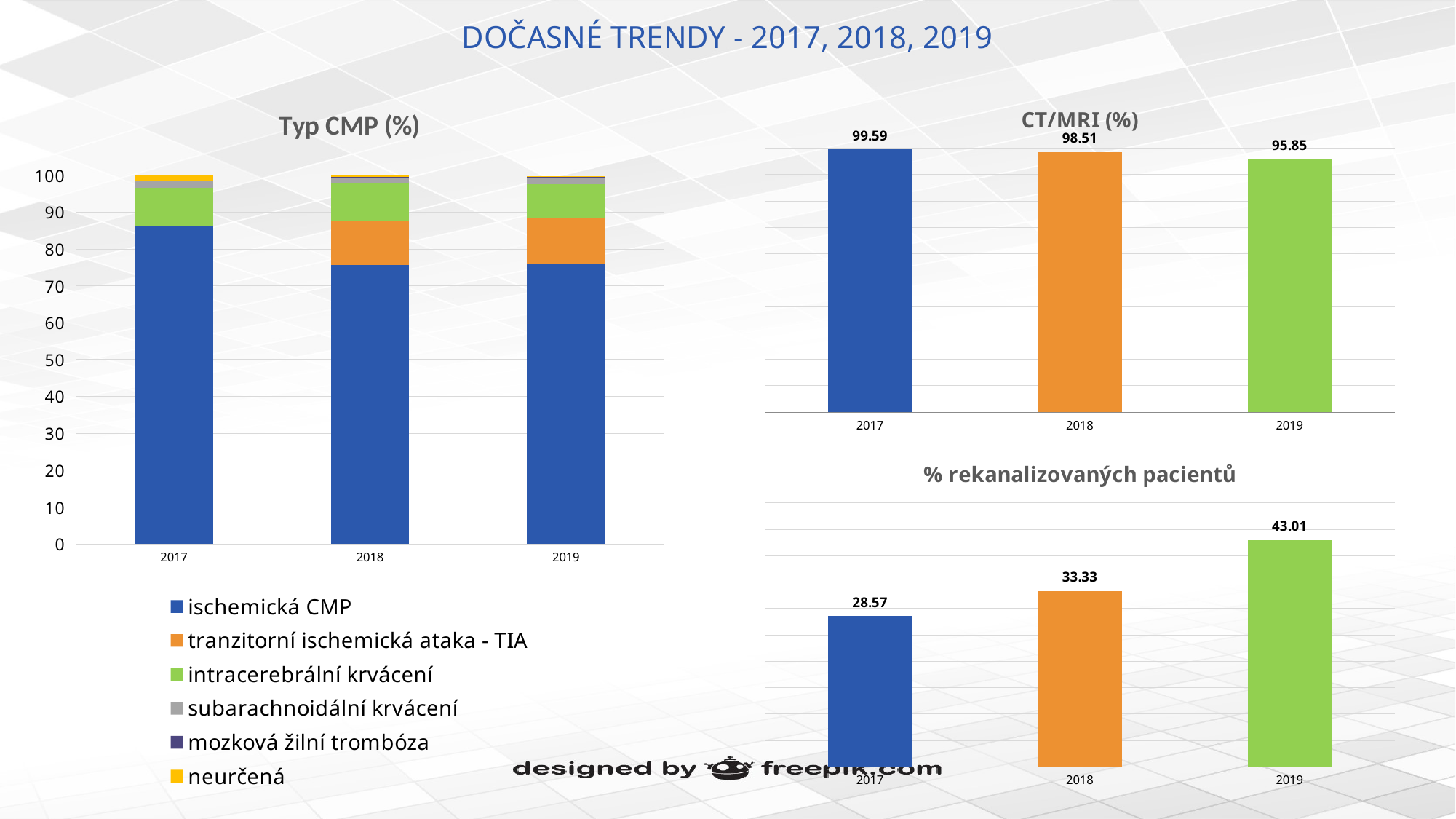
What kind of chart is the 'Typ CMP (%)' chart? stacked bar chart In the 'CT/MRI (%)' chart, do the values rise or fall from 2017 to 2019? fall In the '% rekanalizovaných pacientů' chart, do the values rise or fall from 2017 to 2019? rise In the 'CT/MRI (%)' chart, which year has the lowest value? 2019 In the 'CT/MRI (%)' chart, what is the value for 2017? 99.59 In the 'Typ CMP (%)' chart, is the value for 'ischemická CMP' in 2017 greater or less than 80? greater In the 'CT/MRI (%)' chart, what is the value for 2019? 95.85 In the '% rekanalizovaných pacientů' chart, which year has the highest value? 2019 In the '% rekanalizovaných pacientů' chart, what is the value for 2018? 33.33 In the 'CT/MRI (%)' chart, what is the difference between the values for 2017 and 2018? 1.08 In the '% rekanalizovaných pacientů' chart, what is the difference between the values for 2019 and 2017? 14.44 How many series does the legend of the 'Typ CMP (%)' chart list? 6